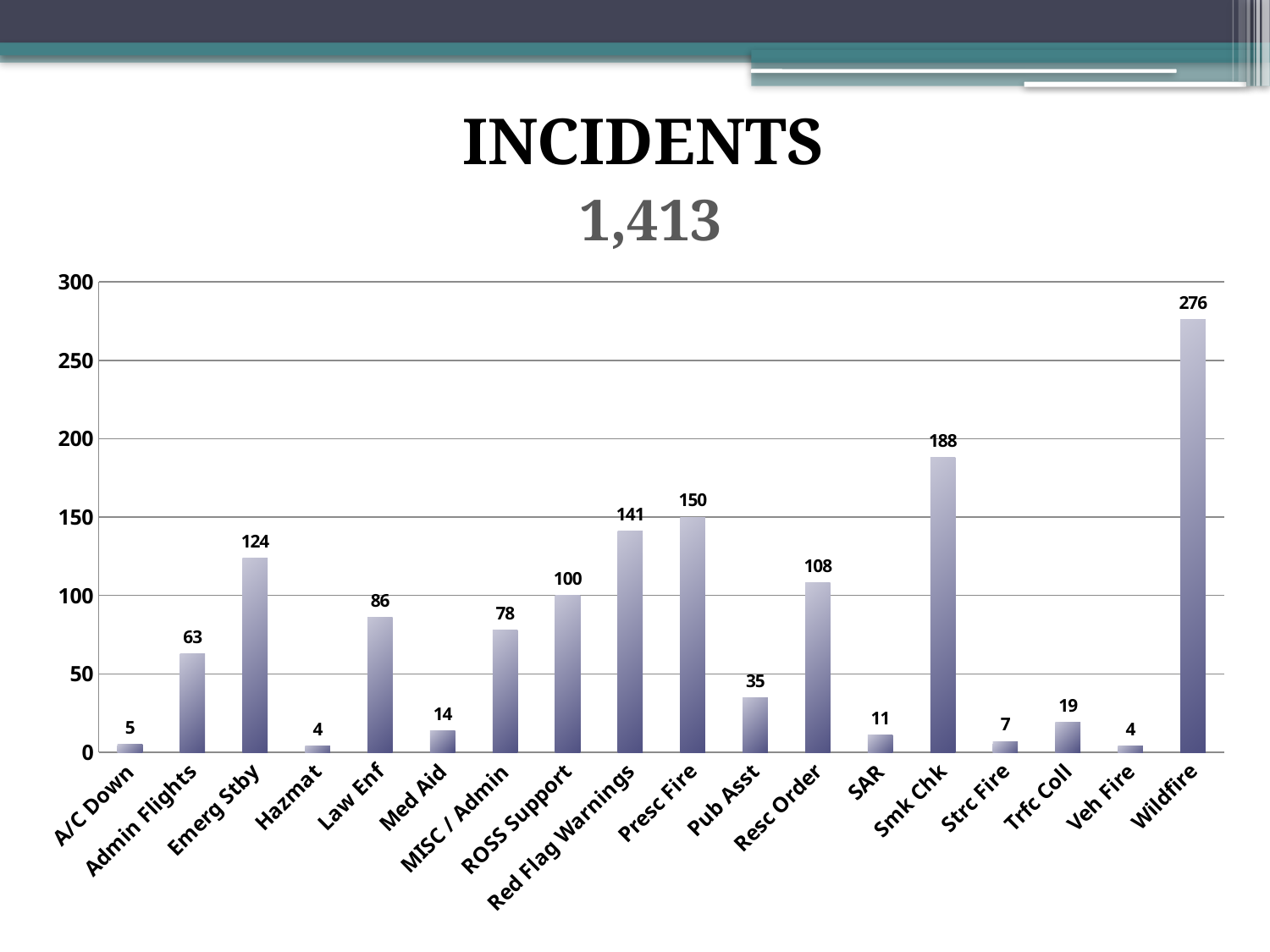
What is the title of the chart? INCIDENTS What is the value for Red Flag Warnings? 141 Which is larger, the value for Law Enf or the value for MISC / Admin? Law Enf Which is larger, the value for Emerg Stby or the value for Resc Order? Emerg Stby What is the value for Smk Chk? 188 How many categories are shown on the x axis? 18 What is the difference between the values for Wildfire and Smk Chk? 88 What kind of chart is shown on the slide? bar chart What is the value for Admin Flights? 63 Which category has the highest value? Wildfire Is the value for ROSS Support greater or less than 150? less What is the difference between the values for Presc Fire and Pub Asst? 115